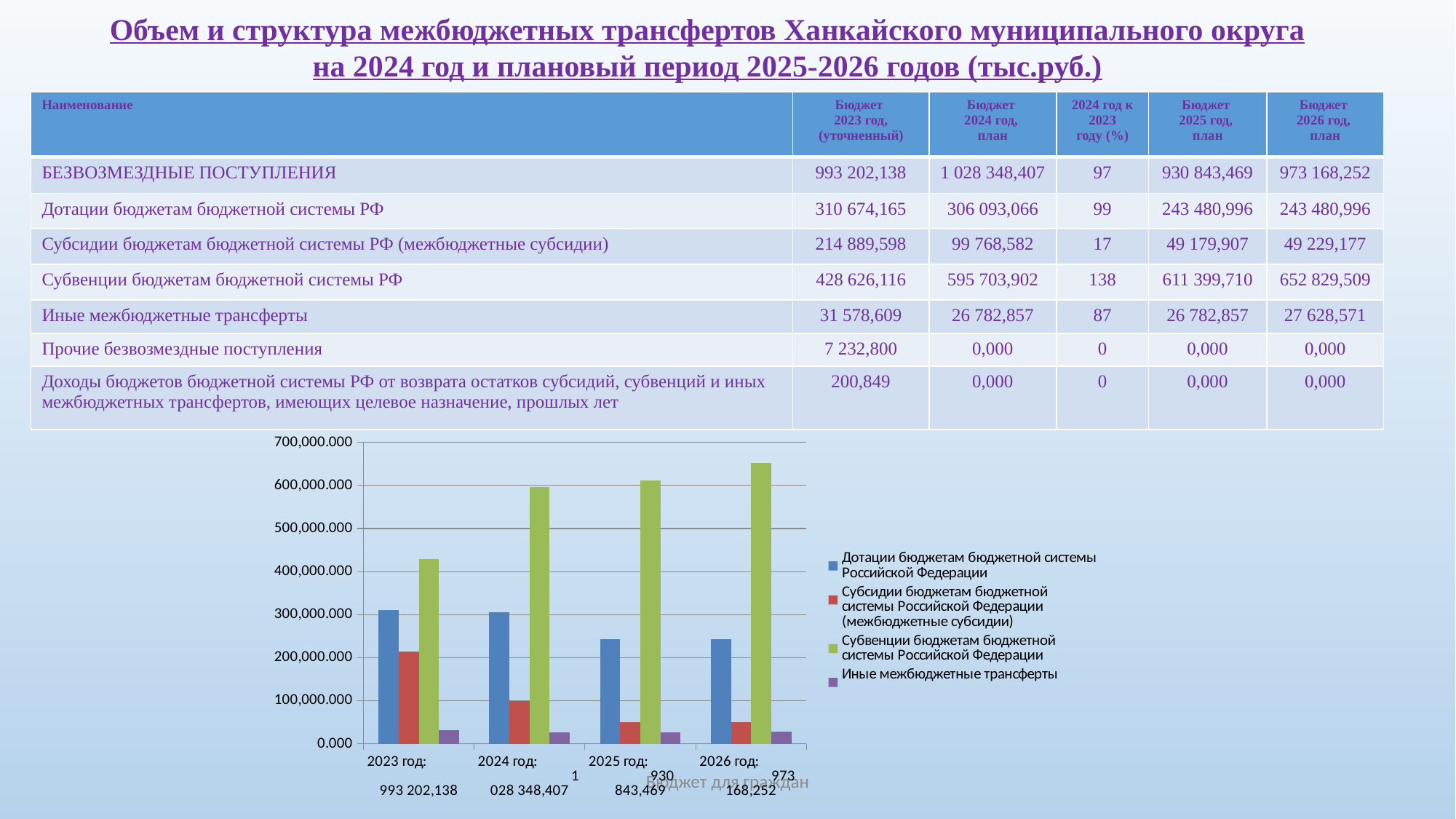
Is the chart value for Дотации бюджетам бюджетной системы Российской Федерации in 2025 год greater or less than 300,000.000? less In the chart, do the bars for Субвенции бюджетам бюджетной системы Российской Федерации rise or fall from 2023 год to 2026 год? rise In the chart, which series has the tallest bar for 2023 год? Субвенции бюджетам бюджетной системы Российской Федерации In the chart, in which year is the bar for Субвенции бюджетам бюджетной системы Российской Федерации the highest? 2026 год Is the chart value for Субсидии бюджетам бюджетной системы Российской Федерации (межбюджетные субсидии) in 2024 год greater or less than 200,000.000? less Is the chart value for Субвенции бюджетам бюджетной системы Российской Федерации in 2026 год greater or less than 600,000.000? greater How many year categories are shown along the x axis of the chart? 4 What kind of chart is shown below the table on the slide? bar chart In the chart, do the bars for Субсидии бюджетам бюджетной системы Российской Федерации (межбюджетные субсидии) rise or fall from 2023 год to 2025 год? fall In the chart, which is larger for 2024 год: Субвенции бюджетам бюджетной системы Российской Федерации or Дотации бюджетам бюджетной системы Российской Федерации? Субвенции бюджетам бюджетной системы Российской Федерации In the chart, which series has the shortest bar for 2024 год? Иные межбюджетные трансферты How many series does the chart legend list? 4